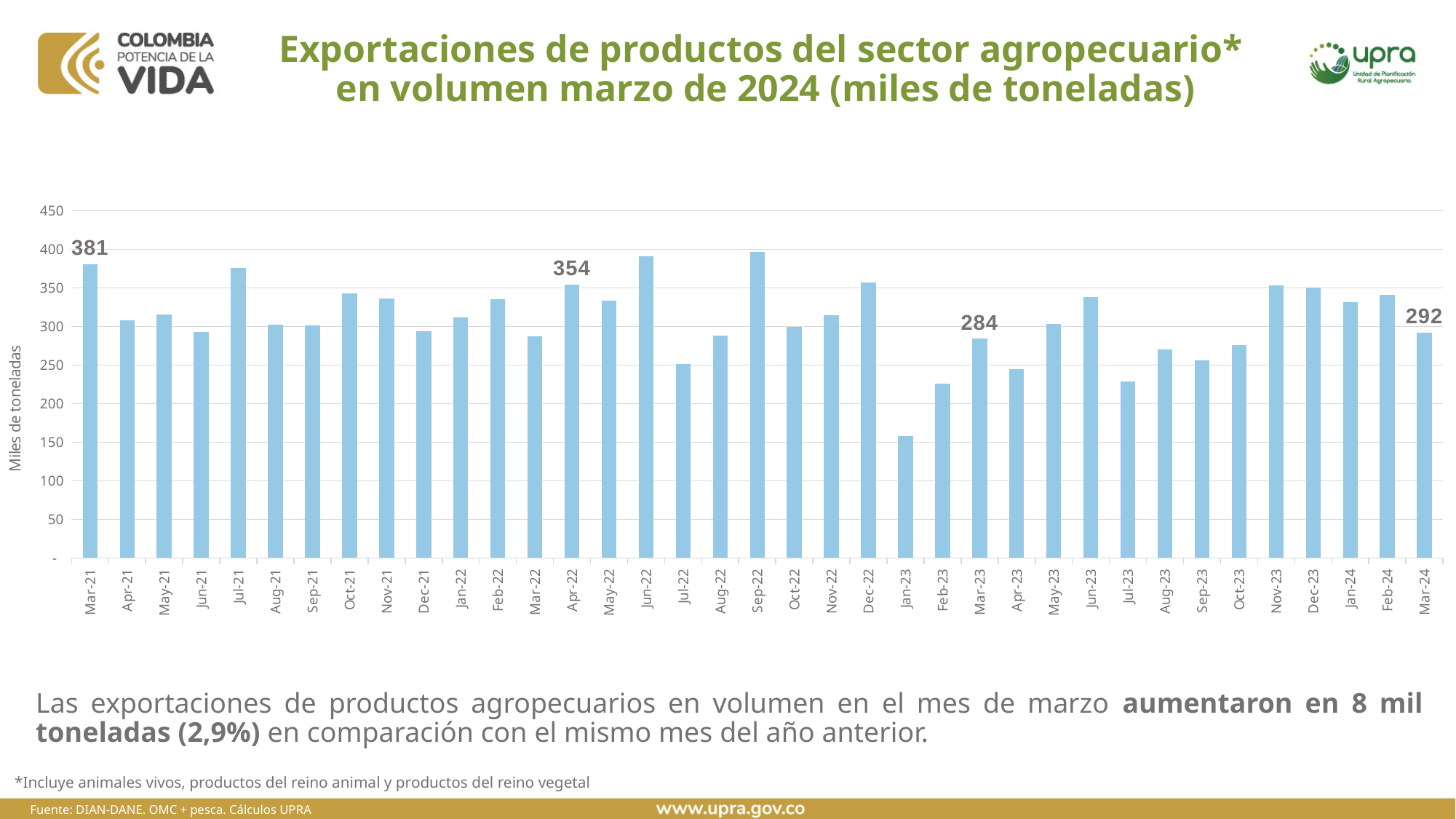
Is the value for Jan-23 greater or less than 200? less How many months are plotted on the chart? 37 Which is larger, the value for Mar-21 or the value for Mar-24? Mar-21 Is the value for Sep-22 greater or less than 350? greater Which month has the lowest value? Jan-23 What is the value for Mar-24? 292 What is the difference between the values for Mar-24 and Mar-23? 8 What is the value for Mar-23? 284 What kind of chart is shown? bar chart What is the difference between the values for Mar-21 and Mar-24? 89 What is the value for Mar-21? 381 What is the value for Apr-22? 354